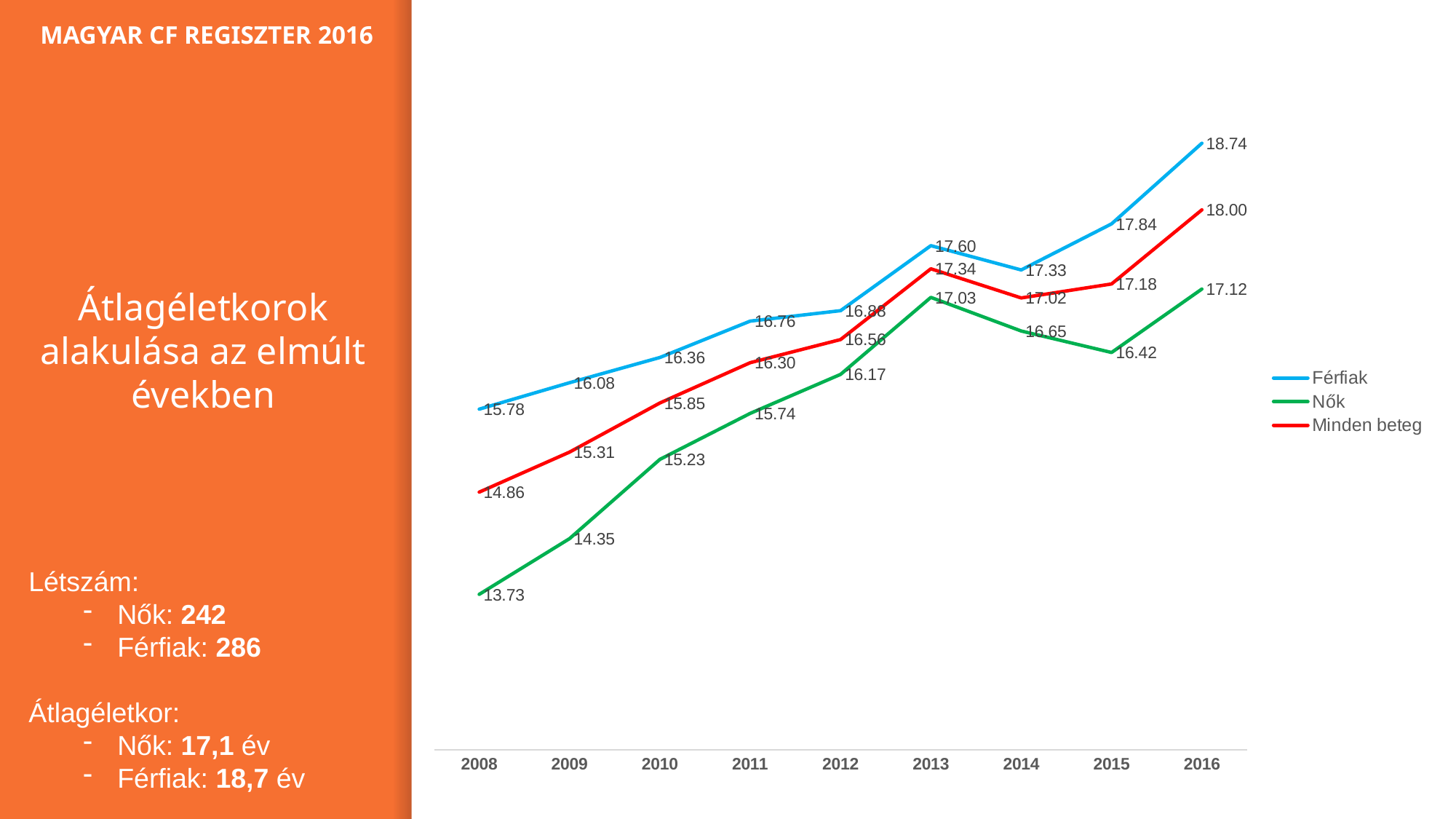
Does the Minden beteg series rise or fall from 2008 to 2013? Rise What is the value for Férfiak in 2016? 18.74 Which is larger in 2014, the value for Férfiak or the value for Nők? Férfiak What is the value for Minden beteg in 2013? 17.34 What type of chart is shown on the slide? Line chart Which series is drawn in red? Minden beteg In which year is the Férfiak series at its highest? 2016 How many series does the legend list? 3 In which year is the Nők series at its lowest? 2008 What is the difference between the Férfiak and Nők values in 2016? 1.62 How many years are shown on the x axis? 9 What is the value for Nők in 2008? 13.73